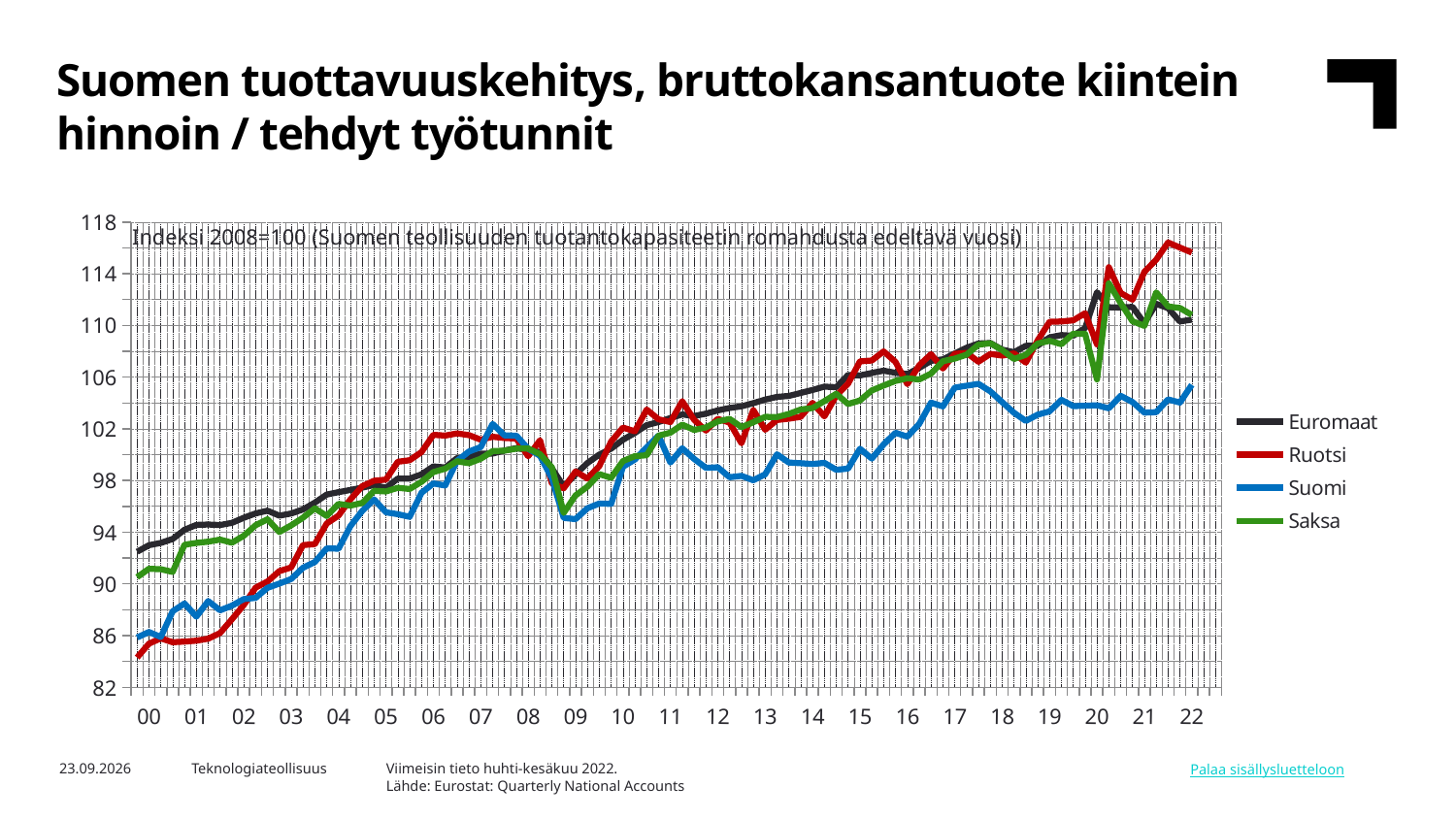
What kind of chart is shown on the slide? line chart Is the value for Suomi at the start of 2000 greater or less than 90? less Which series has the lowest value at the end of the chart in 2022? Suomi Does the Suomi series rise or fall between 2000 and 2008? rise At the start of 2000, which is higher: Euromaat or Suomi? Euromaat Is the value for Ruotsi at the end of 2022 greater or less than 114? greater Which series has the lowest value at the start of the chart in 2000? Ruotsi How many series does the legend list? 4 Which year is the index base year (=100) according to the text inside the chart? 2008 Which series are listed in the legend? Euromaat, Ruotsi, Suomi, Saksa Which series has the highest value at the end of the chart in 2022? Ruotsi Is the value for Suomi at the end of 2022 greater or less than 110? less